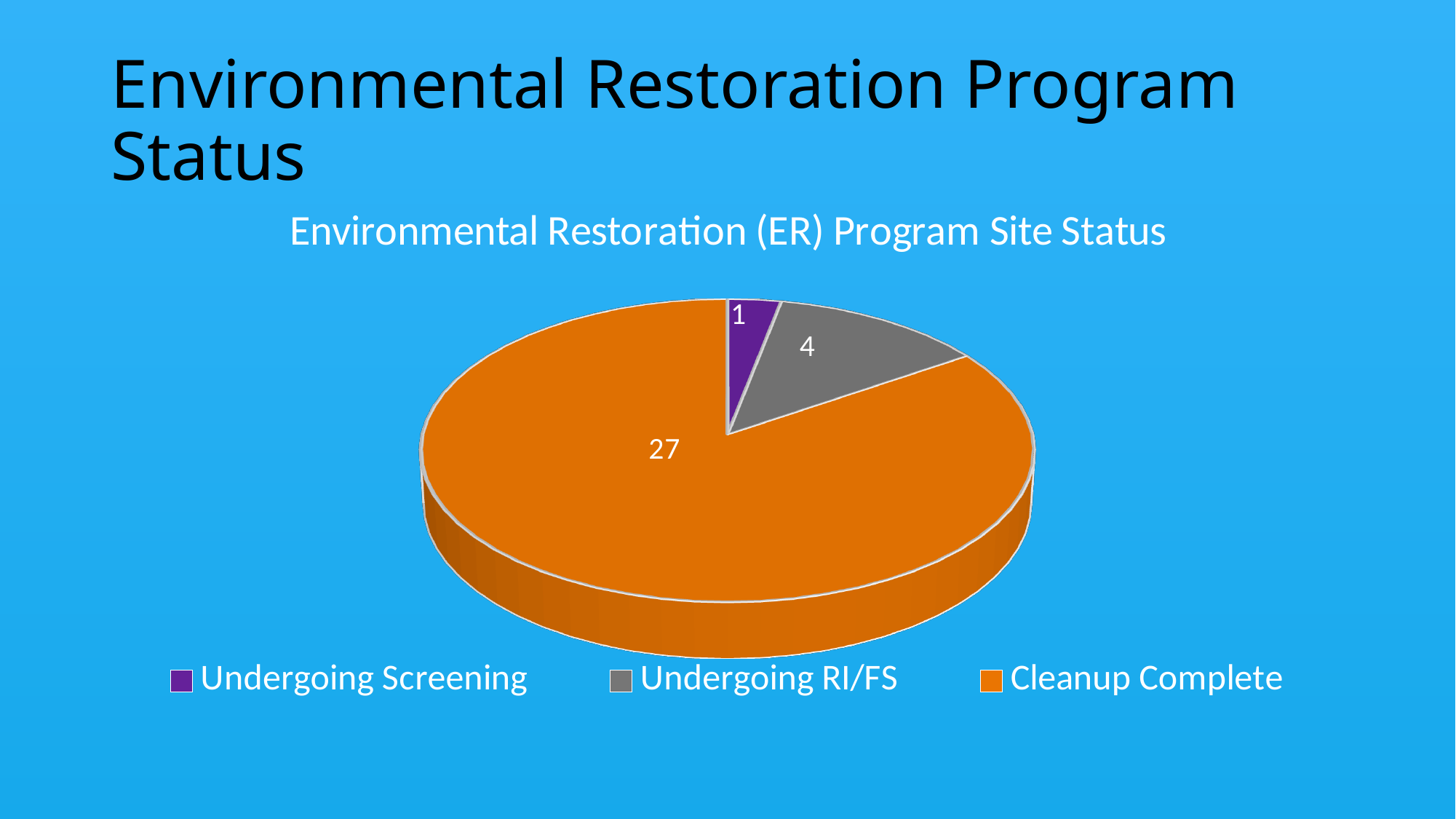
What is the total of all the slices in the pie chart? 32 What is the value for Undergoing RI/FS? 4 Which category has the largest slice of the pie? Cleanup Complete What is the difference between the values for Cleanup Complete and Undergoing RI/FS? 23 What is the difference between the values for Undergoing RI/FS and Undergoing Screening? 3 How many categories does the pie chart show? 3 Which is larger, the value for Undergoing RI/FS or the value for Undergoing Screening? Undergoing RI/FS What is the title of the chart? Environmental Restoration (ER) Program Site Status Which category has the smallest slice of the pie? Undergoing Screening What is the value for Cleanup Complete? 27 What kind of chart is shown on the slide? Pie chart What is the value for Undergoing Screening? 1